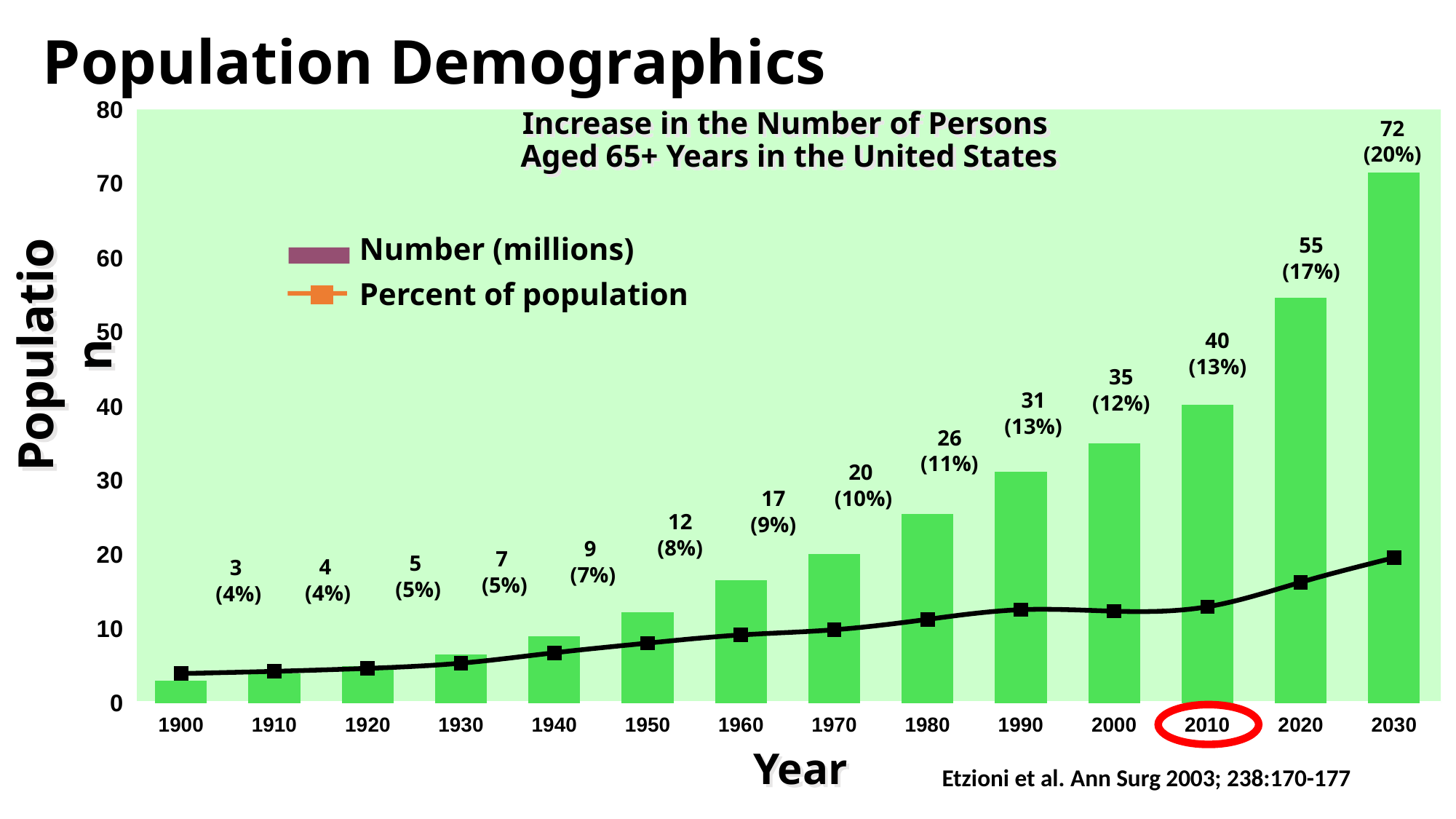
What is the title of the chart? Increase in the Number of Persons Aged 65+ Years in the United States What is the number (millions) of persons aged 65+ in 2010? 40 How many series does the legend list? 2 How many years are shown on the x axis? 14 Does the number of persons aged 65+ rise or fall from 1900 to 2030? Rise What percent of the population was aged 65+ in 1950? 8% What is the number (millions) of persons aged 65+ in 2030? 72 Which year has the lowest number of persons aged 65+? 1900 Which year has the highest number of persons aged 65+? 2030 What is the difference in number (millions) between 2020 and 2010? 15 Which year has a larger number of persons aged 65+, 1980 or 1990? 1990 What kind of chart is used for the Number (millions) series? Bar chart